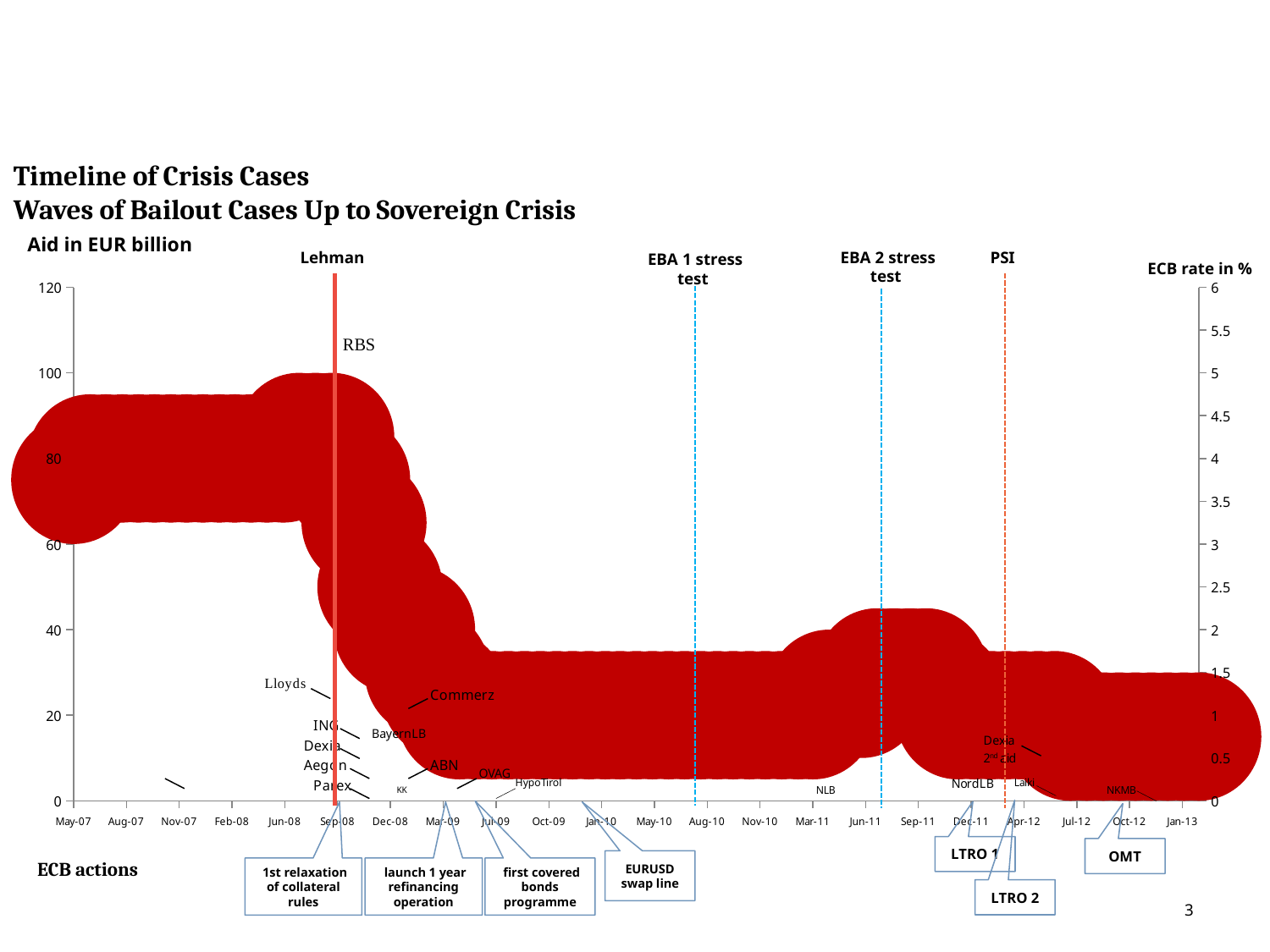
Does the ECB rate line rise or fall between Sep-08 and Jul-09? fall What is the label of the left vertical axis? Aid in EUR billion Is the ECB rate at Jan-13 greater or less than 2%? less Is the ECB rate at May-07 greater or less than 3%? greater What is the highest tick value shown on the right vertical axis (ECB rate in %)? 6 What is the highest tick value shown on the left vertical axis? 120 How many ECB action boxes are shown below the x axis? 7 How many labelled vertical event lines (Lehman, EBA stress tests, PSI) cross the chart? 4 Which is higher, the ECB rate at Jun-08 or the ECB rate at Jan-13? Jun-08 What is the label of the right vertical axis? ECB rate in % What kind of chart is shown on the slide? bubble chart Around which event marker does the ECB rate line reach its highest level? Lehman